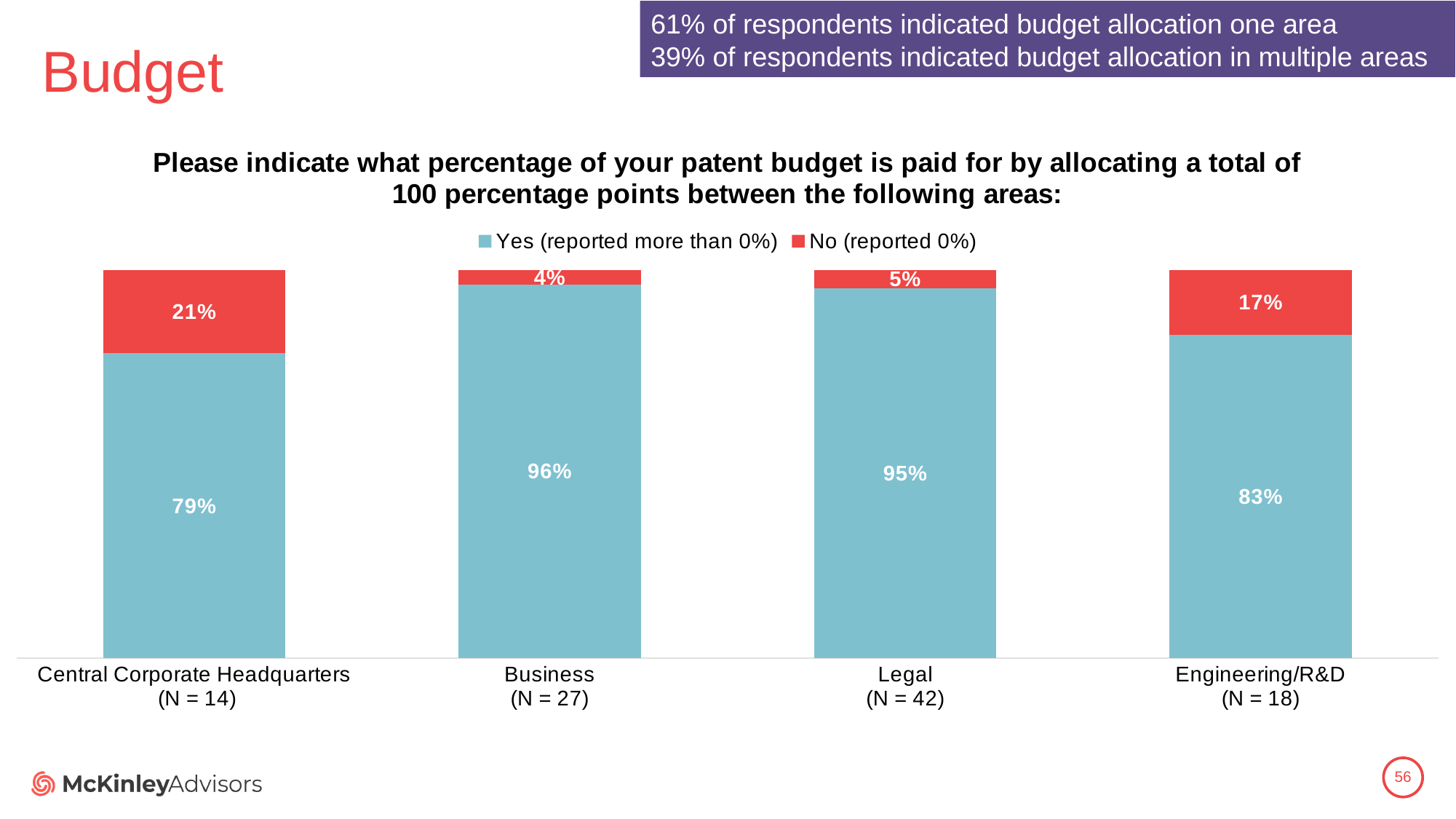
What is the difference between the 'No (reported 0%)' values for Central Corporate Headquarters and Engineering/R&D? 4% How many series does the chart legend list? 2 What kind of chart is shown on the slide? Stacked bar chart What is the sample size (N) shown for the Legal category? 42 Which has a larger 'Yes (reported more than 0%)' value, Engineering/R&D or Legal? Legal What percentage of Central Corporate Headquarters respondents reported more than 0% (Yes)? 79% What is the 'Yes (reported more than 0%)' value for Legal? 95% How many categories are shown on the x axis of the chart? 4 What percentage of Business respondents reported 0% (No)? 4% Which category has the lowest 'Yes (reported more than 0%)' value? Central Corporate Headquarters What is the 'No (reported 0%)' value for Engineering/R&D? 17% Which category has the highest 'Yes (reported more than 0%)' value? Business